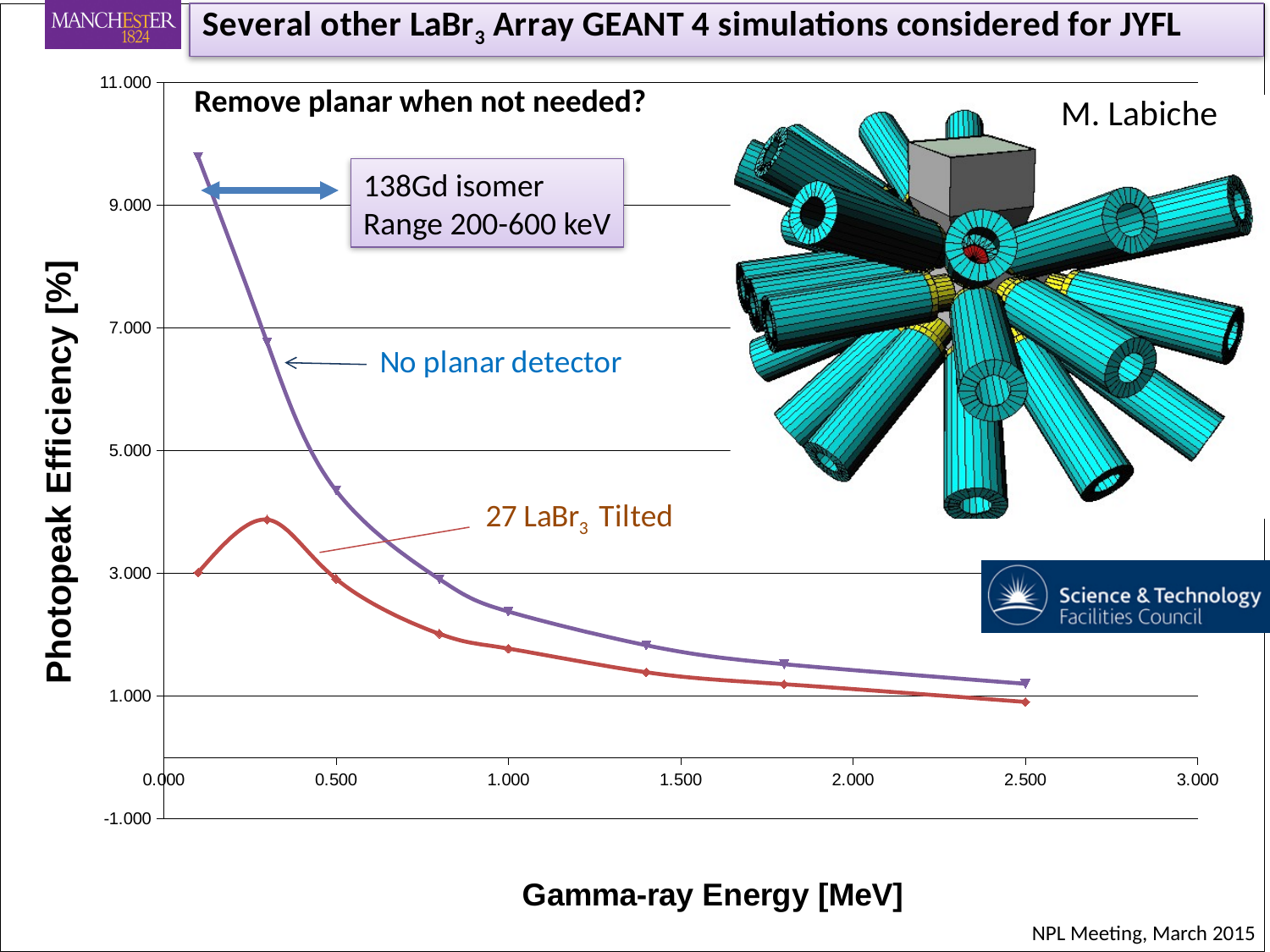
Is the photopeak efficiency of the '27 LaBr3 Tilted' series at 0.300 MeV greater or less than 3.000? greater What is the highest value shown on the y axis? 11.000 Is the photopeak efficiency of the 'No planar detector' series at 1.000 MeV greater or less than 3.000? less Which series has the higher photopeak efficiency at 0.500 MeV, 'No planar detector' or '27 LaBr3 Tilted'? No planar detector Which series reaches the highest photopeak efficiency anywhere on the chart? No planar detector What is the label of the x axis? Gamma-ray Energy [MeV] Is the photopeak efficiency of the 'No planar detector' series at 0.500 MeV greater or less than 3.000? greater Does the 'No planar detector' curve rise or fall as gamma-ray energy increases? fall What is the label of the y axis? Photopeak Efficiency [%] How many data series are plotted on the chart? 2 What kind of chart is shown on the slide? line chart